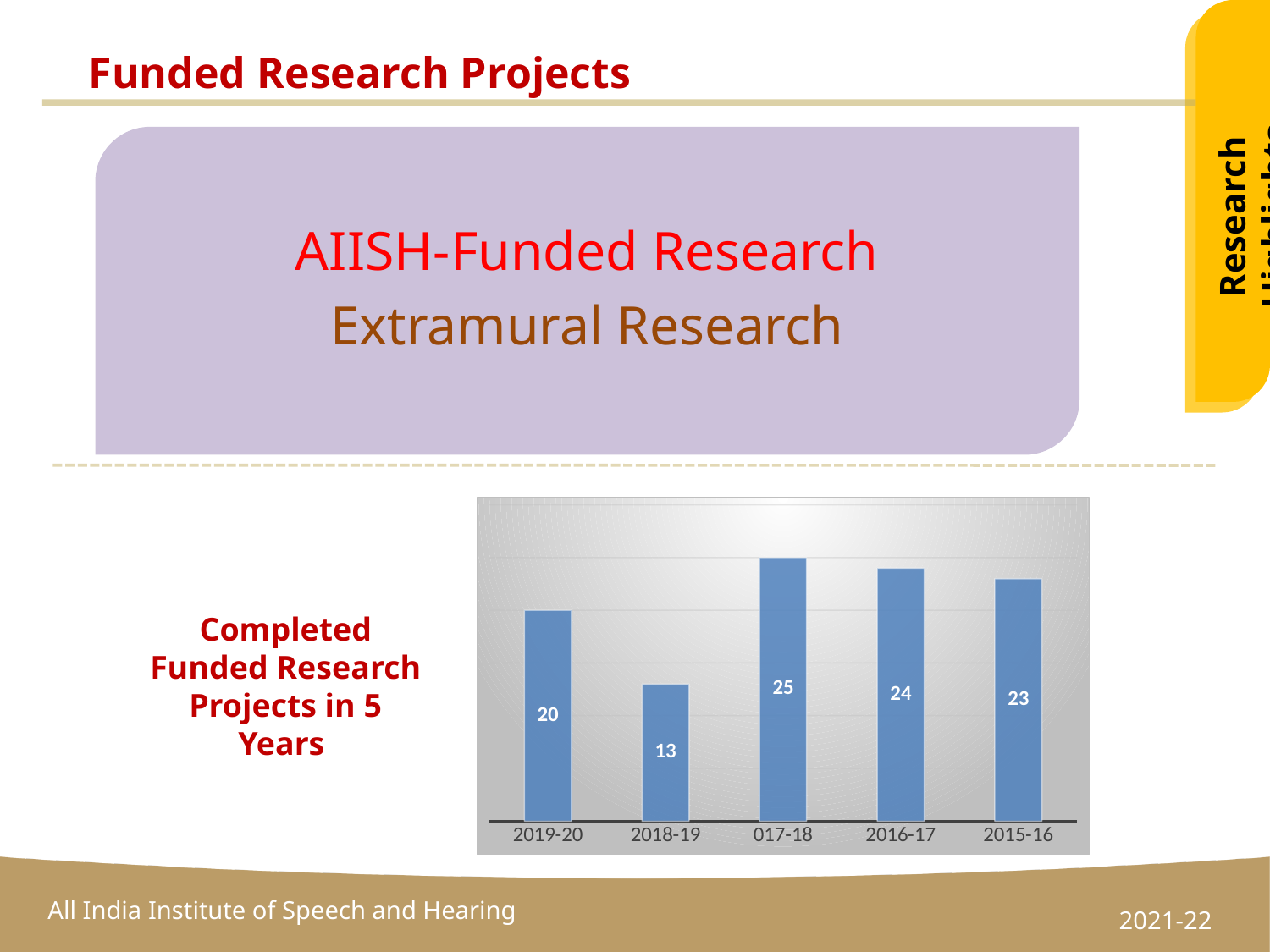
What is the value for 2015-16 in the Completed Funded Research Projects chart? 23 What is the difference between the values for 017-18 and 2018-19? 12 What kind of chart is shown on the slide? Bar chart Which year has the highest number of completed funded research projects? 017-18 What is the value for 2018-19 in the Completed Funded Research Projects chart? 13 Which year has the lowest number of completed funded research projects? 2018-19 What is the value for 2019-20 in the Completed Funded Research Projects chart? 20 Which is larger, the value for 2019-20 or the value for 2015-16? 2015-16 How many years (categories) are shown in the chart? 5 What is the difference between the values for 2016-17 and 2015-16? 1 What is the total of all five values shown in the chart? 105 What is the value for 2016-17 in the Completed Funded Research Projects chart? 24